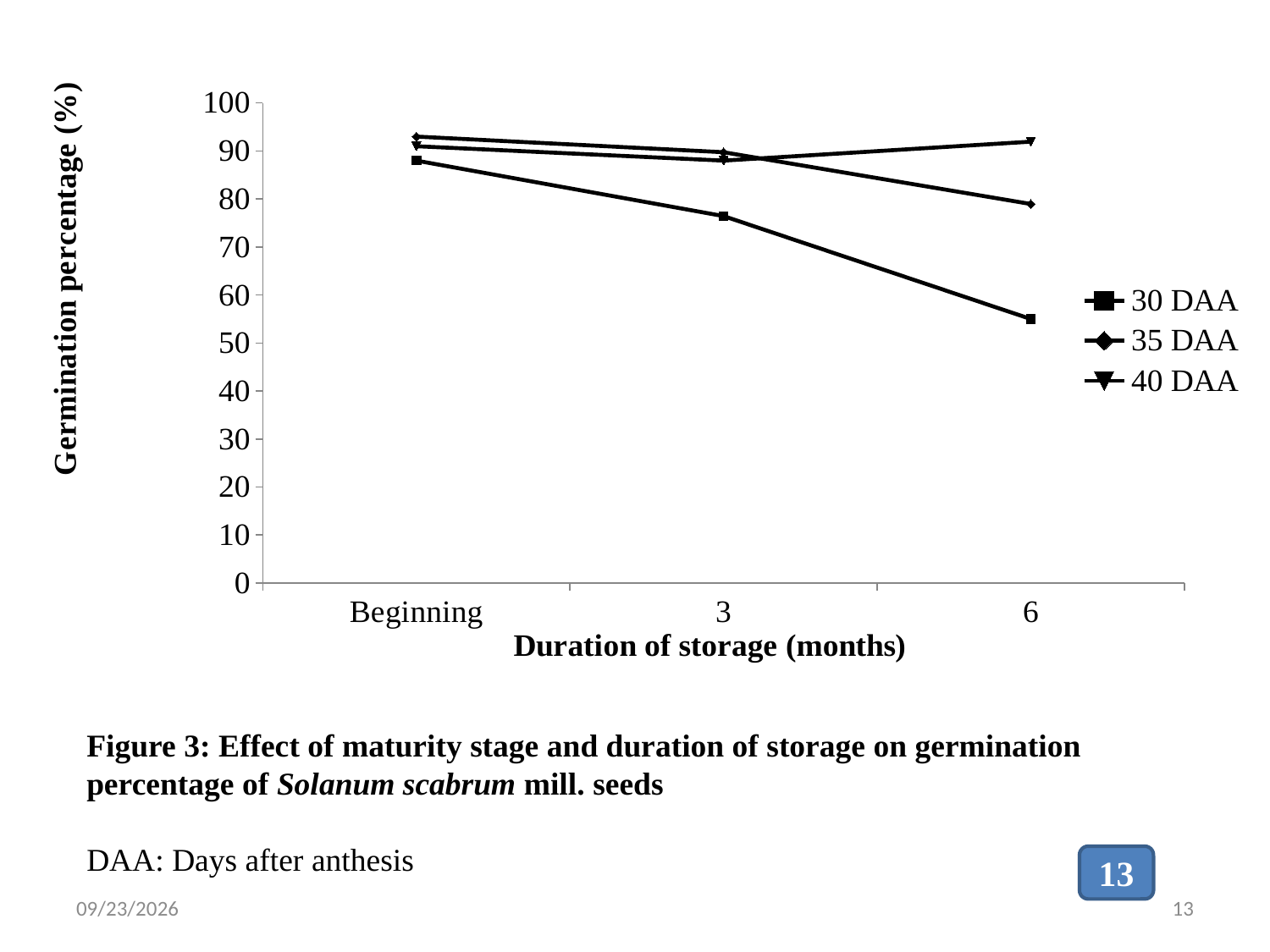
Does the germination percentage for 35 DAA rise or fall from Beginning to 6 months? fall At 6 months of storage, which is larger: the germination percentage for 35 DAA or for 30 DAA? 35 DAA Is the germination percentage for 30 DAA at 3 months greater or less than 80? less How many storage duration points are plotted along the x axis? 3 What kind of chart is shown on the slide? line chart Does the germination percentage for 30 DAA rise or fall as the duration of storage increases? fall What is the title of the y axis? Germination percentage (%) Is the germination percentage for 30 DAA at 6 months greater or less than 60? less Which series has the lowest germination percentage at 6 months of storage? 30 DAA How many series does the legend list? 3 Which series has the highest germination percentage at 6 months of storage? 40 DAA